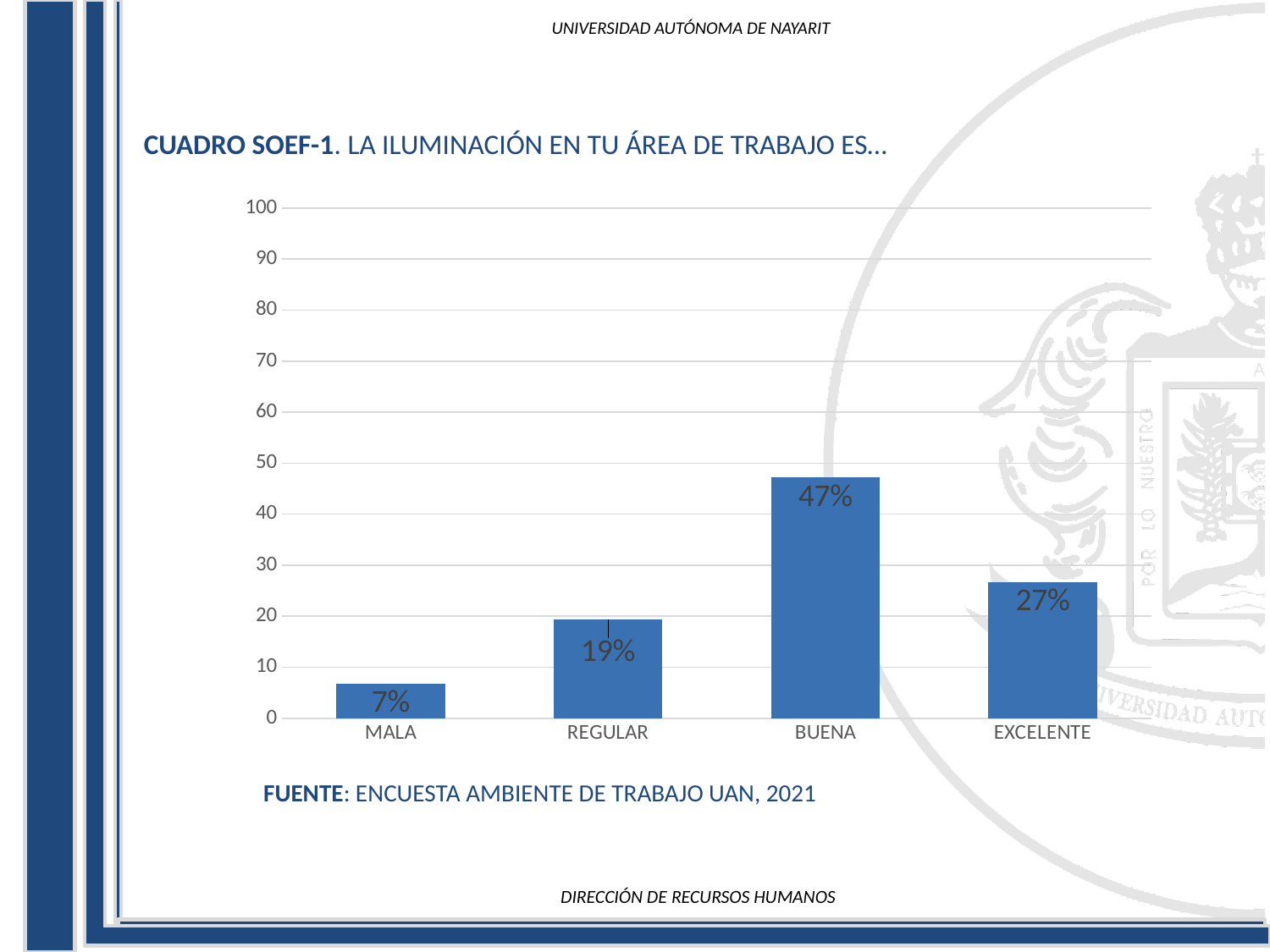
Which category has the highest value? BUENA What is the value for EXCELENTE? 27% What is the value for MALA? 7% Which category has the lowest value? MALA What is the difference between the values for BUENA and EXCELENTE? 20% What kind of chart is shown on the slide? bar chart Is the value for BUENA greater or less than 50? less Which is larger, the value for REGULAR or the value for EXCELENTE? EXCELENTE What is the value for BUENA? 47% How many categories are shown on the x axis? 4 What source is cited below the chart? ENCUESTA AMBIENTE DE TRABAJO UAN, 2021 What is the value for REGULAR? 19%